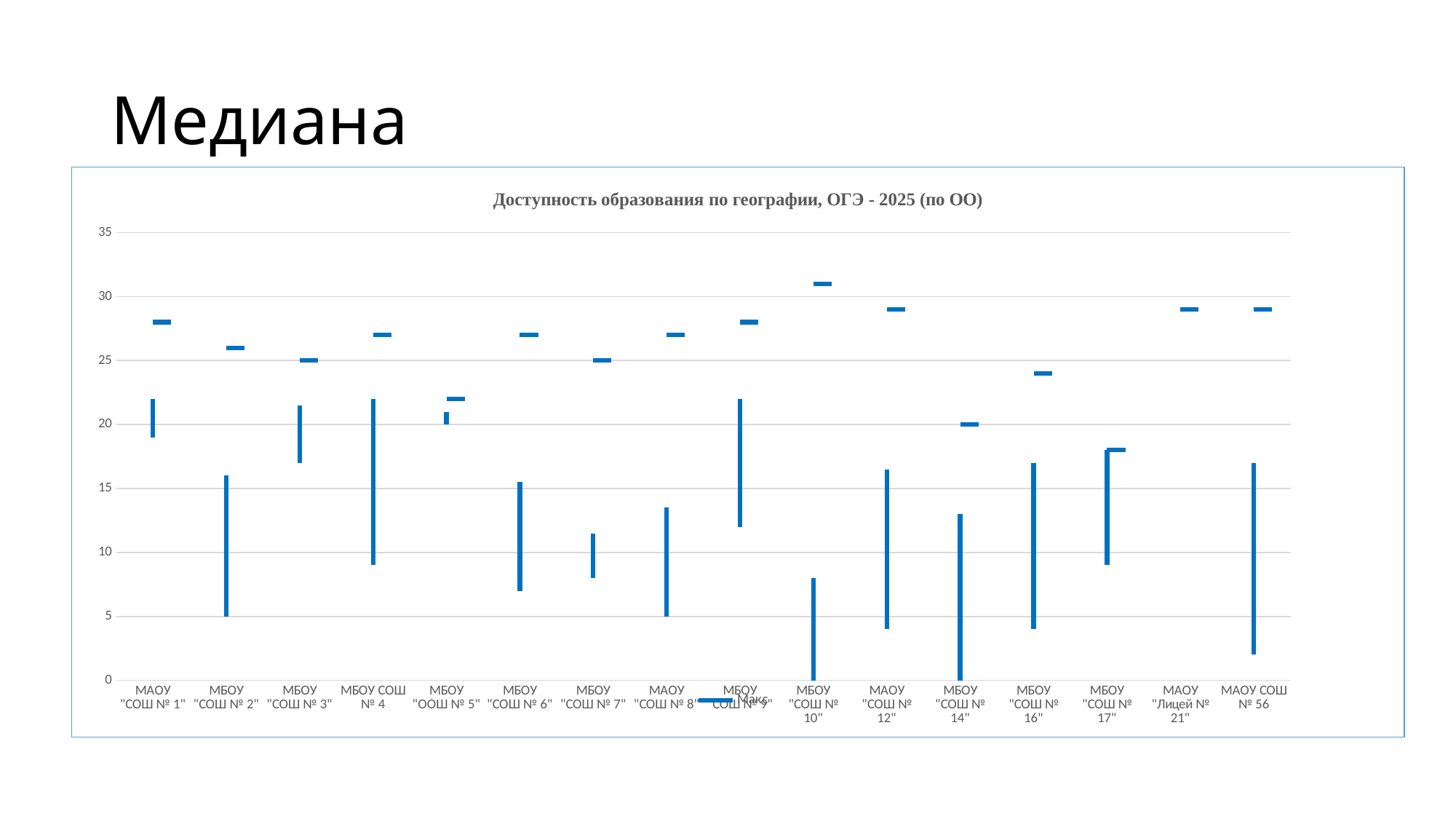
How many schools (categories) are shown on the x axis of the chart? 16 Which school has the lowest Макс marker in the chart? МБОУ "СОШ № 17" Is the Макс value for МБОУ "СОШ № 17" greater or less than 20? less Is the Макс value for МБОУ "СОШ № 10" greater or less than 30? greater What is the title of the chart? Доступность образования по географии, ОГЭ - 2025 (по ОО) Is the Макс value for МБОУ "СОШ № 16" greater or less than 25? less Which has the larger Макс value: МБОУ "СОШ № 16" or МАОУ "СОШ № 12"? МАОУ "СОШ № 12" Which has the larger Макс value: МБОУ "СОШ № 10" or МБОУ "СОШ № 17"? МБОУ "СОШ № 10" What is the name of the series shown in the chart legend? Макс Which school has the highest Макс marker in the chart? МБОУ "СОШ № 10"